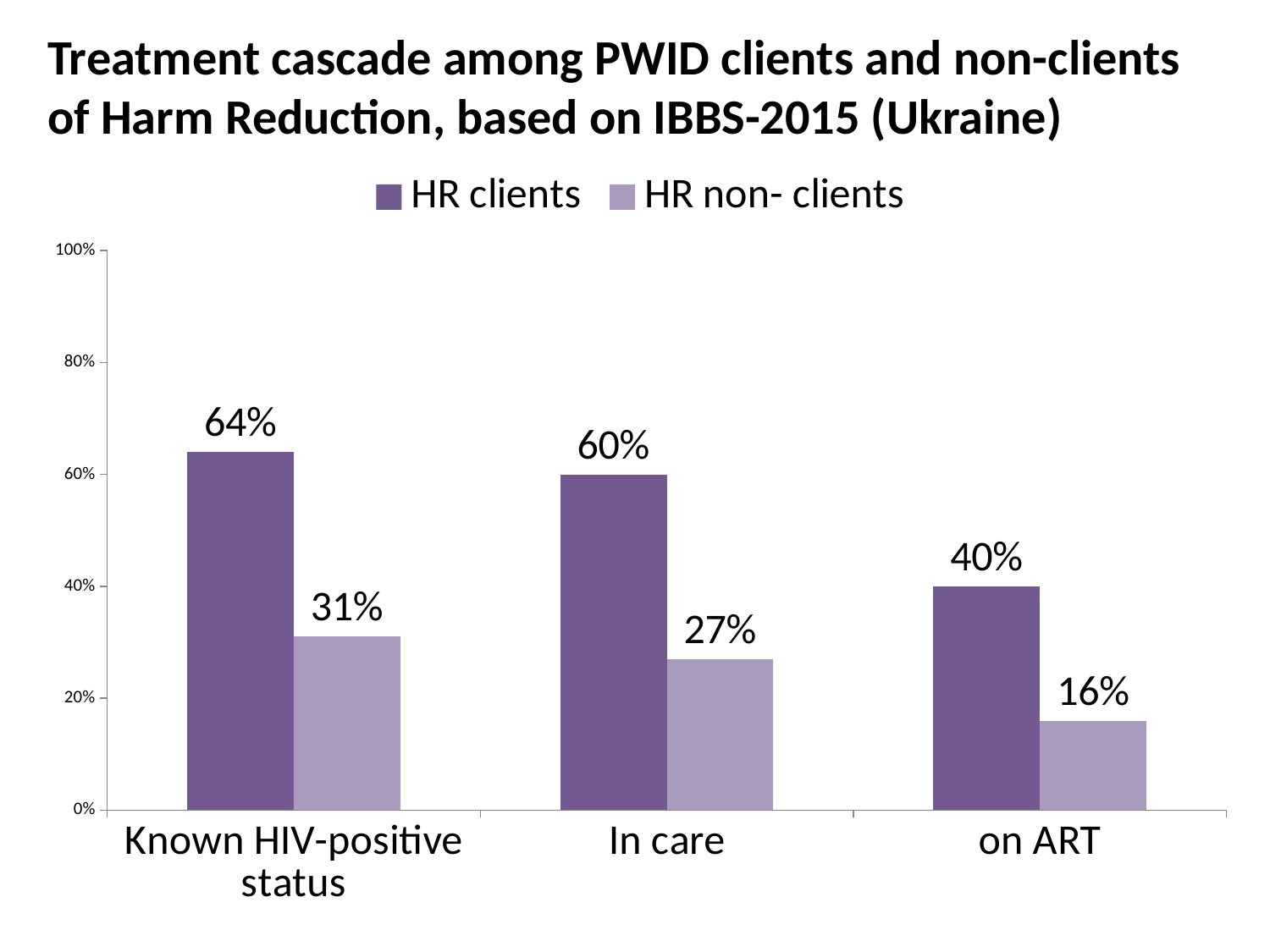
How many series does the legend list? 2 What is the value for HR non- clients in the 'on ART' category? 16% What is the value for HR non- clients in the 'Known HIV-positive status' category? 31% What kind of chart is shown on the slide? Bar chart Which category has the highest value for HR clients? Known HIV-positive status What is the value for HR clients in the 'In care' category? 60% What is the difference between HR clients and HR non- clients in the 'on ART' category? 24% What is the difference between the HR clients values for 'Known HIV-positive status' and 'In care'? 4% Which is larger: HR non- clients in 'Known HIV-positive status' or HR non- clients in 'In care'? Known HIV-positive status How many categories are shown on the x axis? 3 Which category has the lowest value for HR non- clients? on ART Do the HR clients values rise or fall from 'Known HIV-positive status' to 'on ART'? Fall